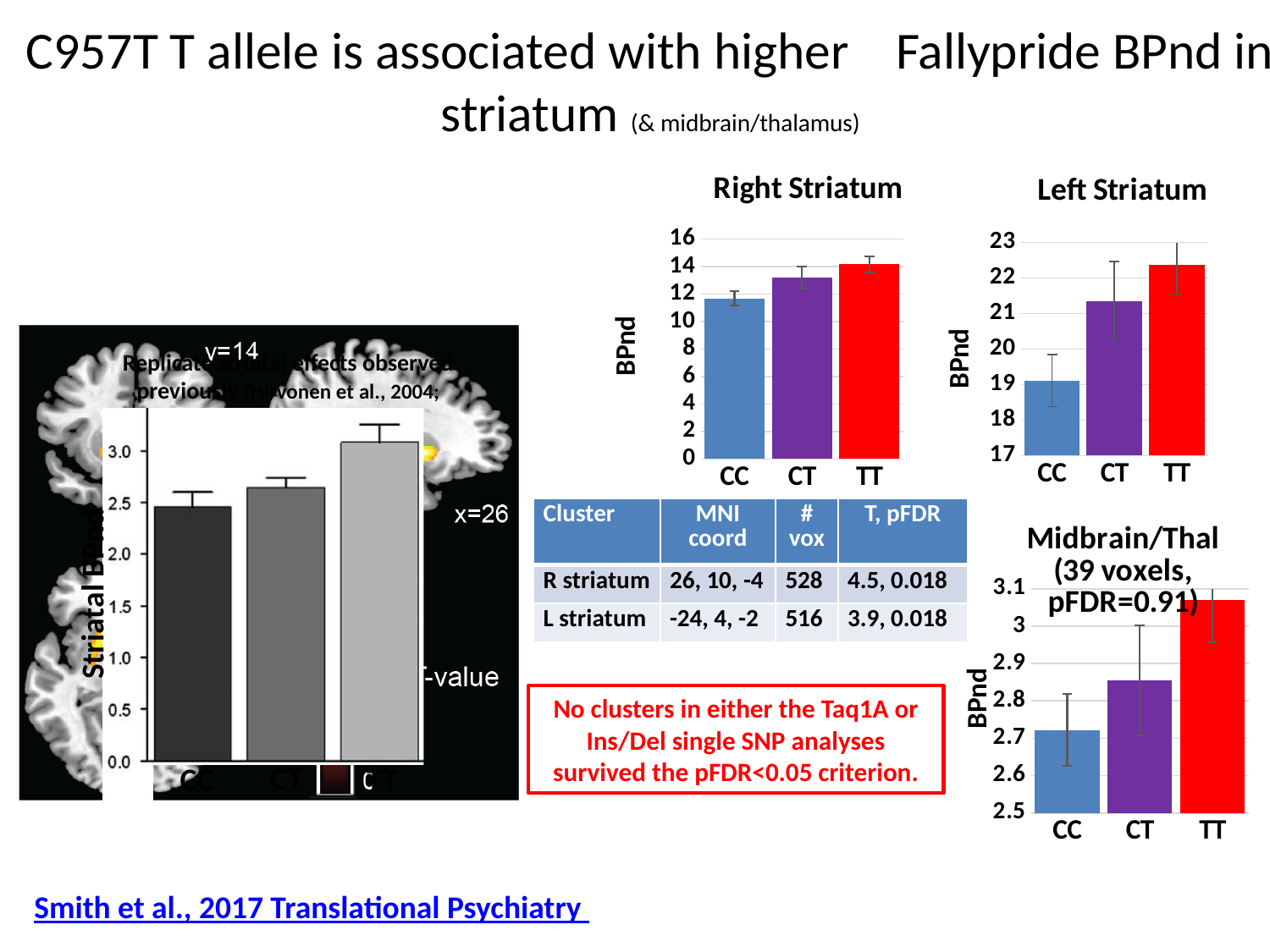
In the Midbrain/Thal chart, do BPnd values rise or fall from CC to TT? rise In the bottom-left Striatal BPnd chart, is the value for CT greater or less than 2.5? greater What kind of chart is the Left Striatum chart? bar chart In the Right Striatum chart, is the BPnd value for CT greater or less than 12? greater In the Midbrain/Thal chart, which genotype has the lowest BPnd? CC In the Left Striatum chart, is the BPnd value for TT greater or less than 22? greater In the Right Striatum chart, which genotype has the highest BPnd? TT How many genotype categories are shown in the Right Striatum chart? 3 In the Right Striatum chart, which genotype has the lowest BPnd? CC In the Left Striatum chart, which genotype has the highest BPnd? TT